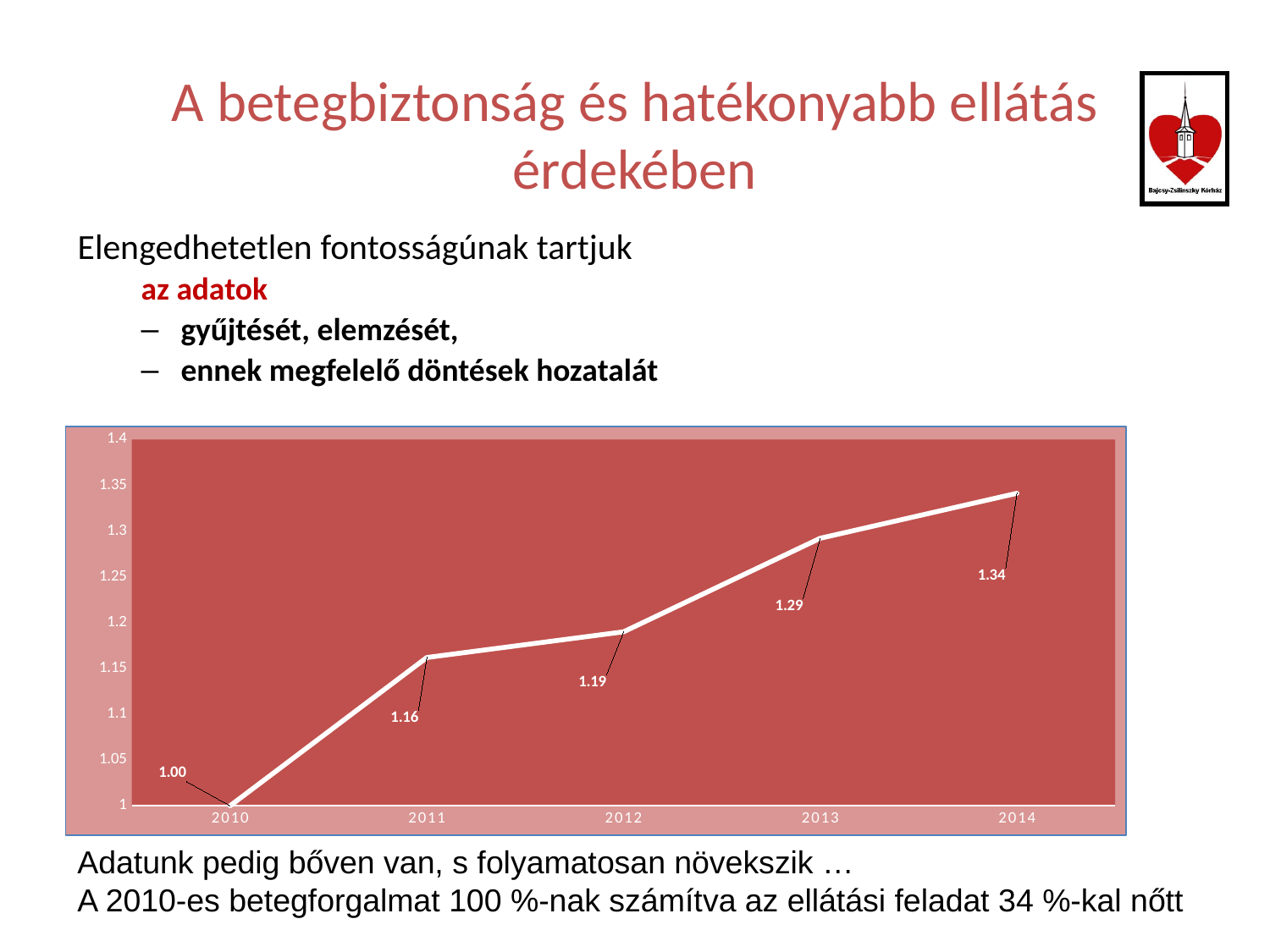
What is the value for 2011? 1.16 Which year has the lowest value? 2010 Which is larger, the value for 2012 or the value for 2011? 2012 What is the value for 2013? 1.29 Is the value for 2013 greater or less than 1.25? greater What is the difference between the values for 2013 and 2012? 0.10 How many years are plotted on the chart? 5 What is the difference between the values for 2014 and 2010? 0.34 Which year has the highest value? 2014 What kind of chart is shown on the slide? line chart What is the value for 2010? 1.00 What is the value for 2014? 1.34